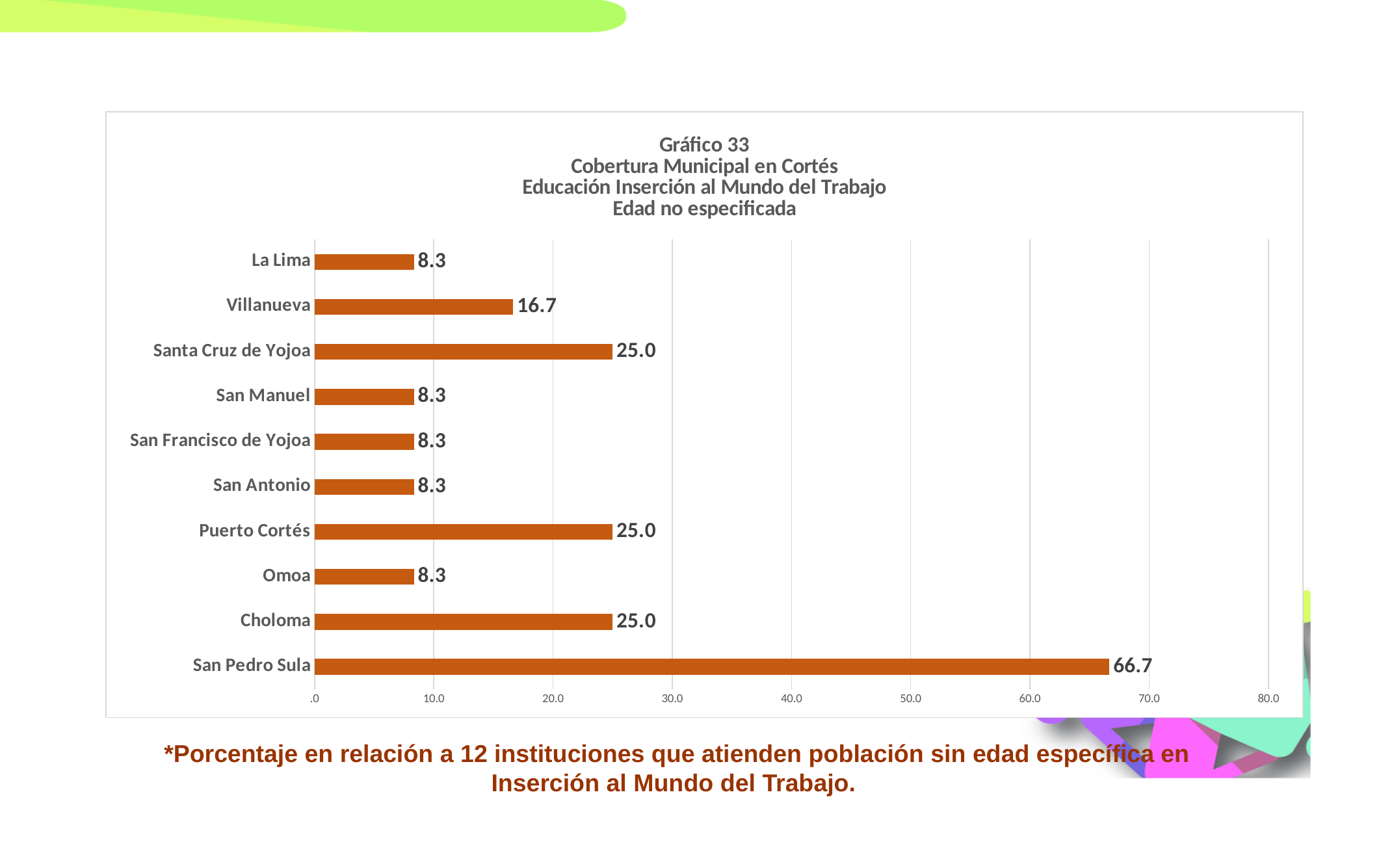
Which is larger, the value for Puerto Cortés or the value for Villanueva? Puerto Cortés Which municipality has the highest value? San Pedro Sula What is the difference between the values for San Pedro Sula and Choloma? 41.7 What is the difference between the values for Villanueva and La Lima? 8.4 What is the value for Santa Cruz de Yojoa? 25.0 What is the value for Omoa? 8.3 What kind of chart is shown on the slide? Bar chart What is the number of the chart given in its title? Gráfico 33 What is the value for San Pedro Sula? 66.7 How many municipalities are shown in the chart? 10 What is the value for Villanueva? 16.7 Is the value for San Pedro Sula greater or less than 60.0? greater